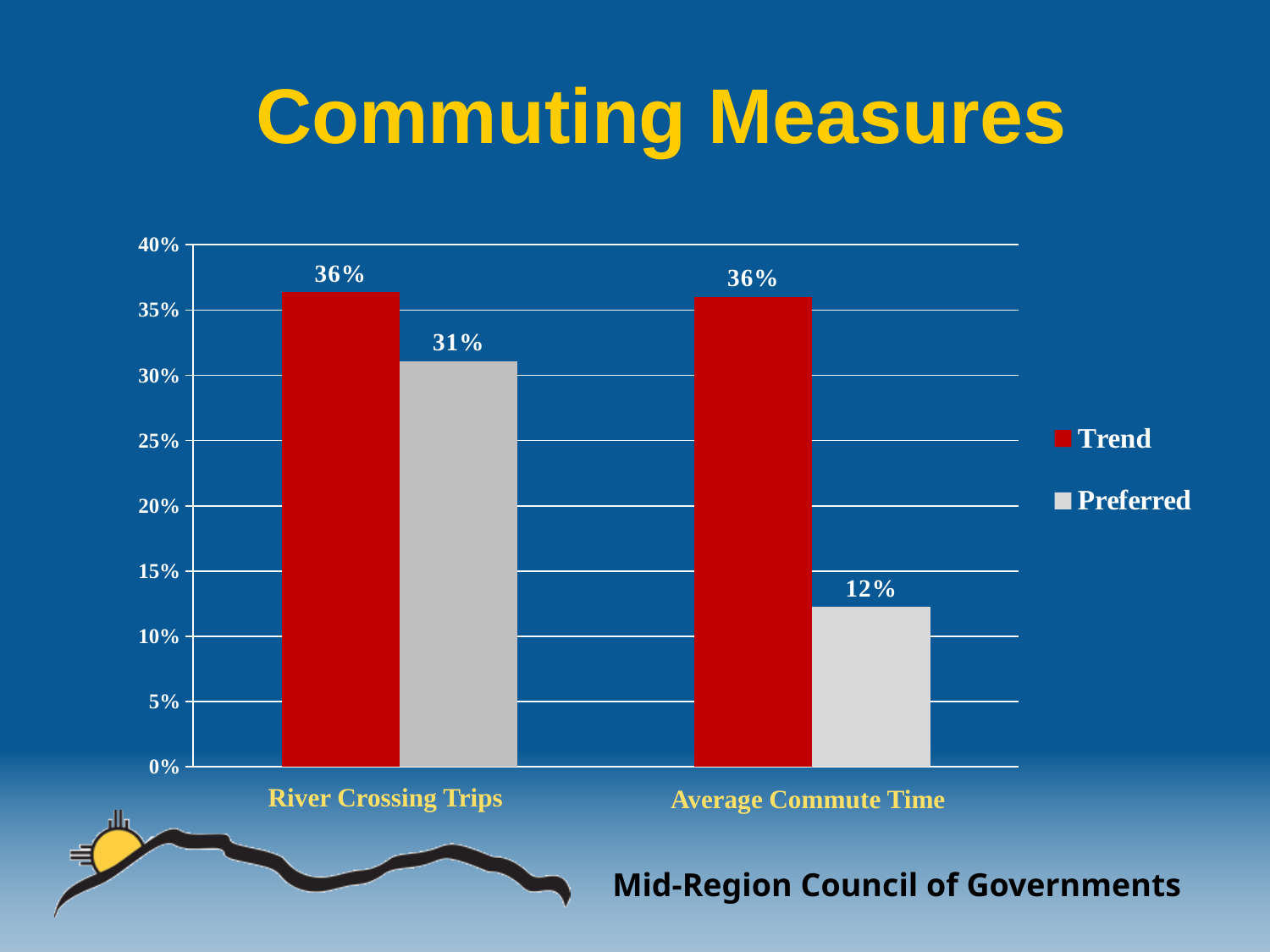
What is the difference between the Trend and Preferred values for River Crossing Trips? 5% How many categories are shown on the x axis? 2 What kind of chart is shown on the slide? Bar chart What is the Trend value for Average Commute Time? 36% What is the Trend value for River Crossing Trips? 36% Which category has the lowest Preferred value? Average Commute Time What is the difference between the Trend and Preferred values for Average Commute Time? 24% Which is larger, the Preferred value for River Crossing Trips or the Preferred value for Average Commute Time? River Crossing Trips What colour represents the Trend series in the legend? Red How many series does the legend list? 2 What is the Preferred value for Average Commute Time? 12% What is the Preferred value for River Crossing Trips? 31%